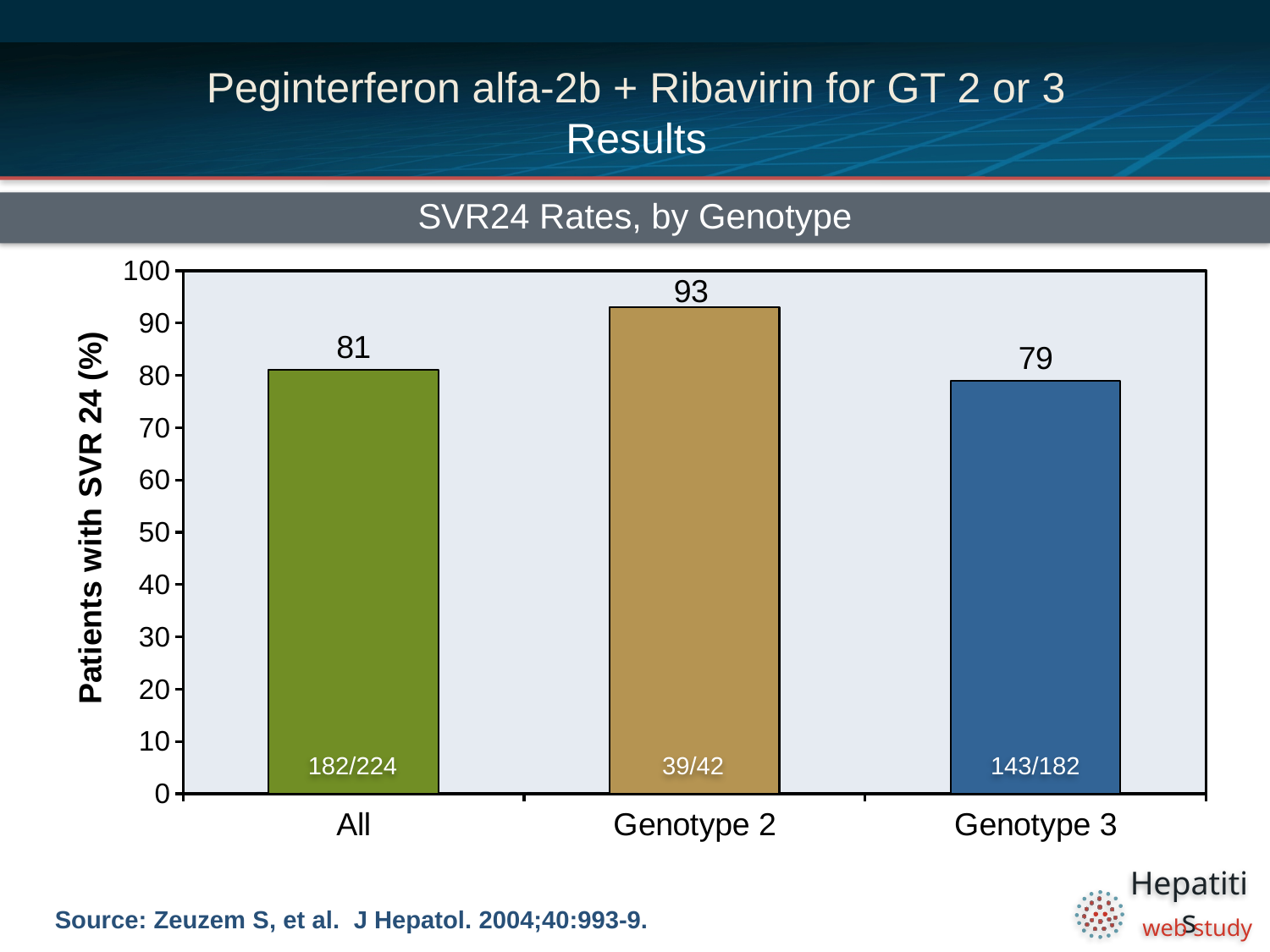
Which has a higher SVR24 rate, All or Genotype 2? Genotype 2 What is the difference between the SVR24 rates for Genotype 2 and Genotype 3? 14 What is the title of the chart? SVR24 Rates, by Genotype Which category has the lowest SVR24 rate? Genotype 3 What is the SVR24 rate for Genotype 3? 79 Which category has the highest SVR24 rate? Genotype 2 What fraction of patients is printed inside the Genotype 2 bar? 39/42 What is the SVR24 rate for Genotype 2? 93 What kind of chart is shown on the slide? Bar chart What is the SVR24 rate for the All group? 81 How many categories are shown on the x axis? 3 Is the SVR24 rate for Genotype 2 greater or less than 90? greater